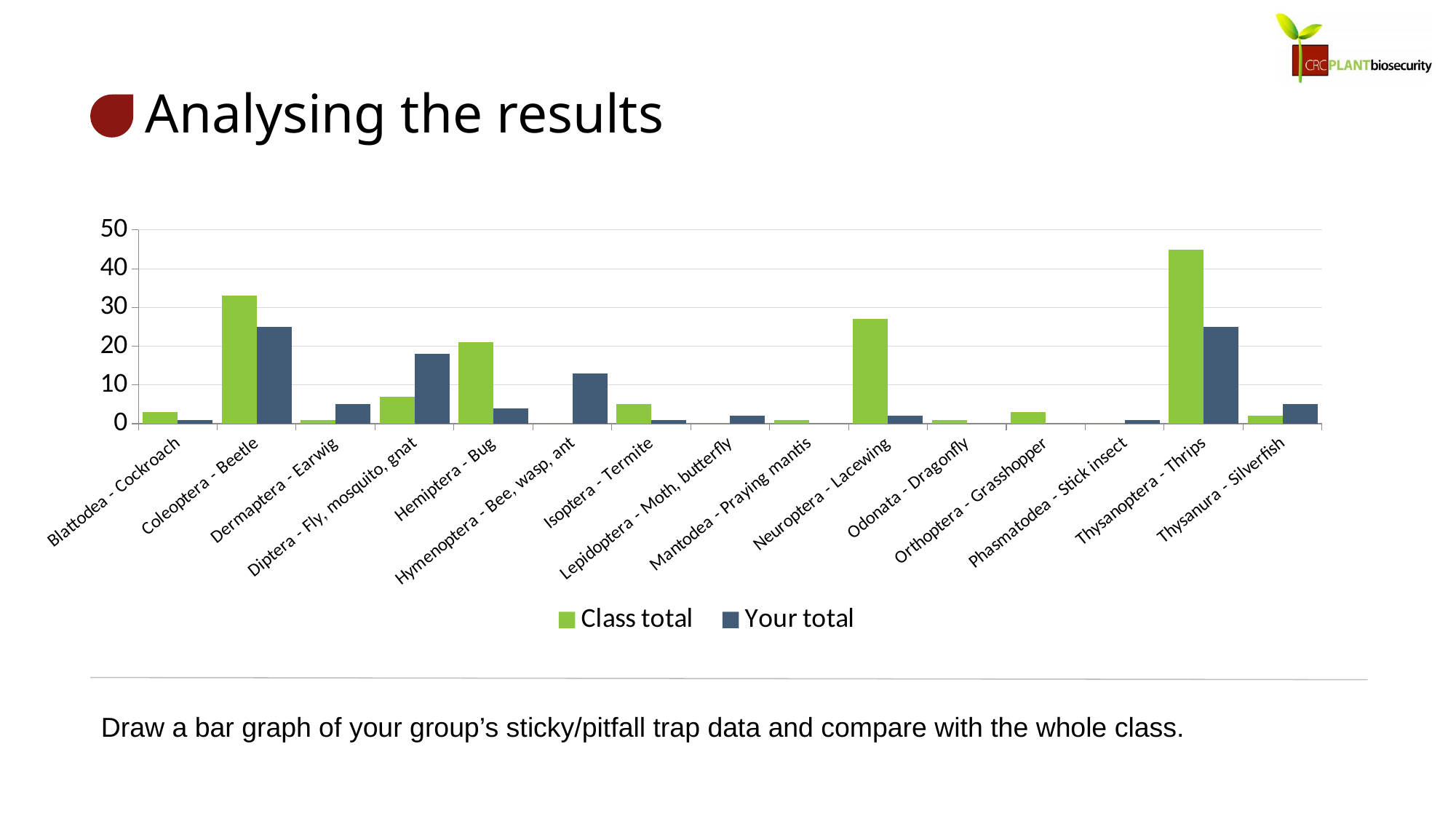
Is the Class total for Thysanoptera - Thrips greater or less than 40? greater Is the Your total for Hymenoptera - Bee, wasp, ant greater or less than 20? less For Diptera - Fly, mosquito, gnat, which is larger: the Class total or the Your total? Your total Which category has the highest Class total? Thysanoptera - Thrips How many insect order categories are shown on the x axis? 15 What kind of chart is shown on the slide? bar chart Is the Your total for Diptera - Fly, mosquito, gnat greater or less than 10? greater How many series does the legend list? 2 What are the two series named in the legend? Class total and Your total Which colour represents the Class total series? green For Coleoptera - Beetle, which is larger: the Class total or the Your total? Class total